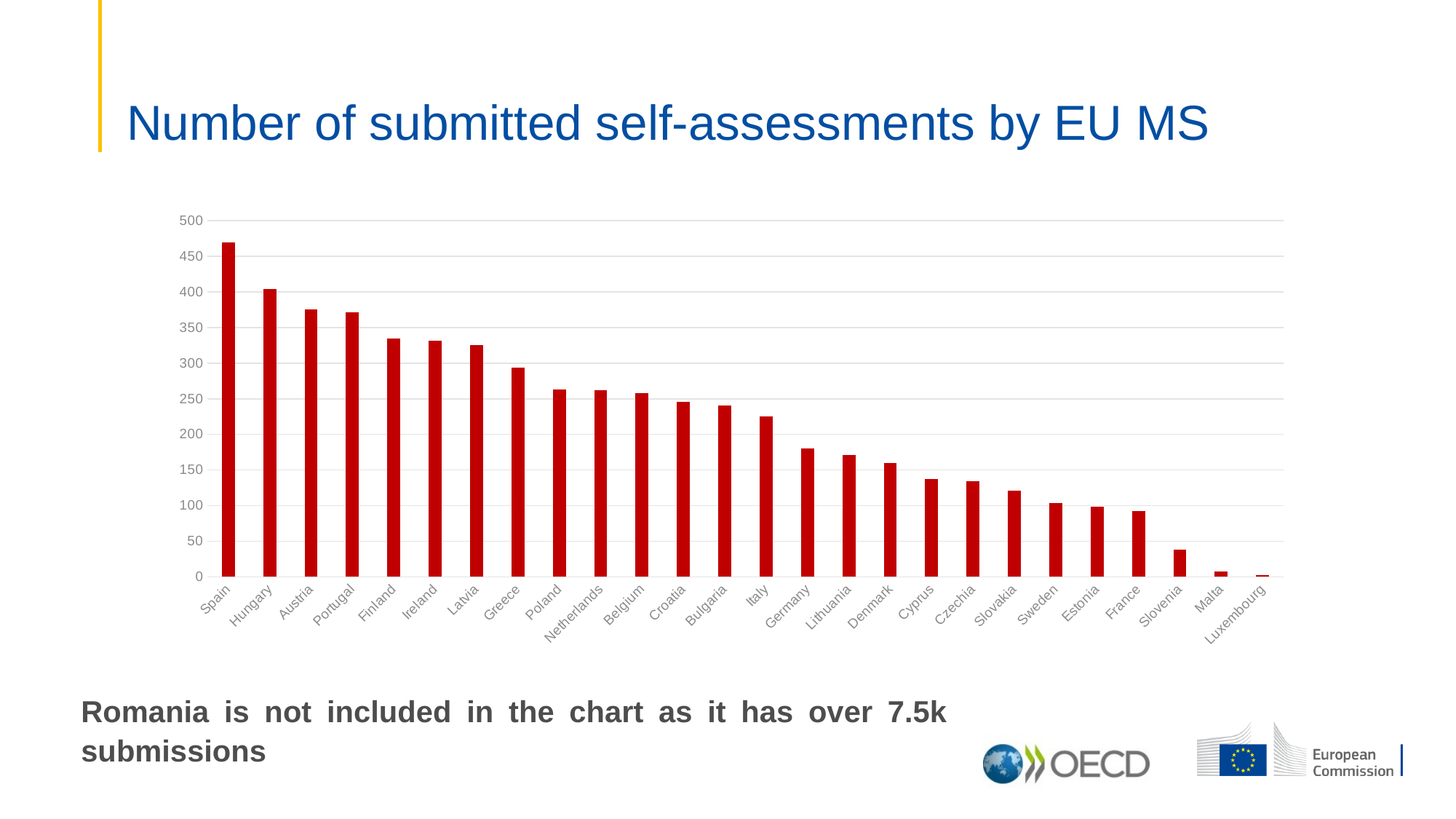
What kind of chart is shown on the slide? bar chart Which has more submitted self-assessments, Italy or Germany? Italy How many EU member states are shown in the chart? 26 Is the value for Spain greater or less than 450? greater Is the value for Cyprus greater or less than 150? less Is the value for Finland greater or less than 300? greater Which EU member state has the highest number of submitted self-assessments in the chart? Spain Which country is noted as not included in the chart because it has over 7.5k submissions? Romania Which EU member state has the lowest number of submitted self-assessments in the chart? Luxembourg Do the values rise or fall moving from left to right along the x axis? fall